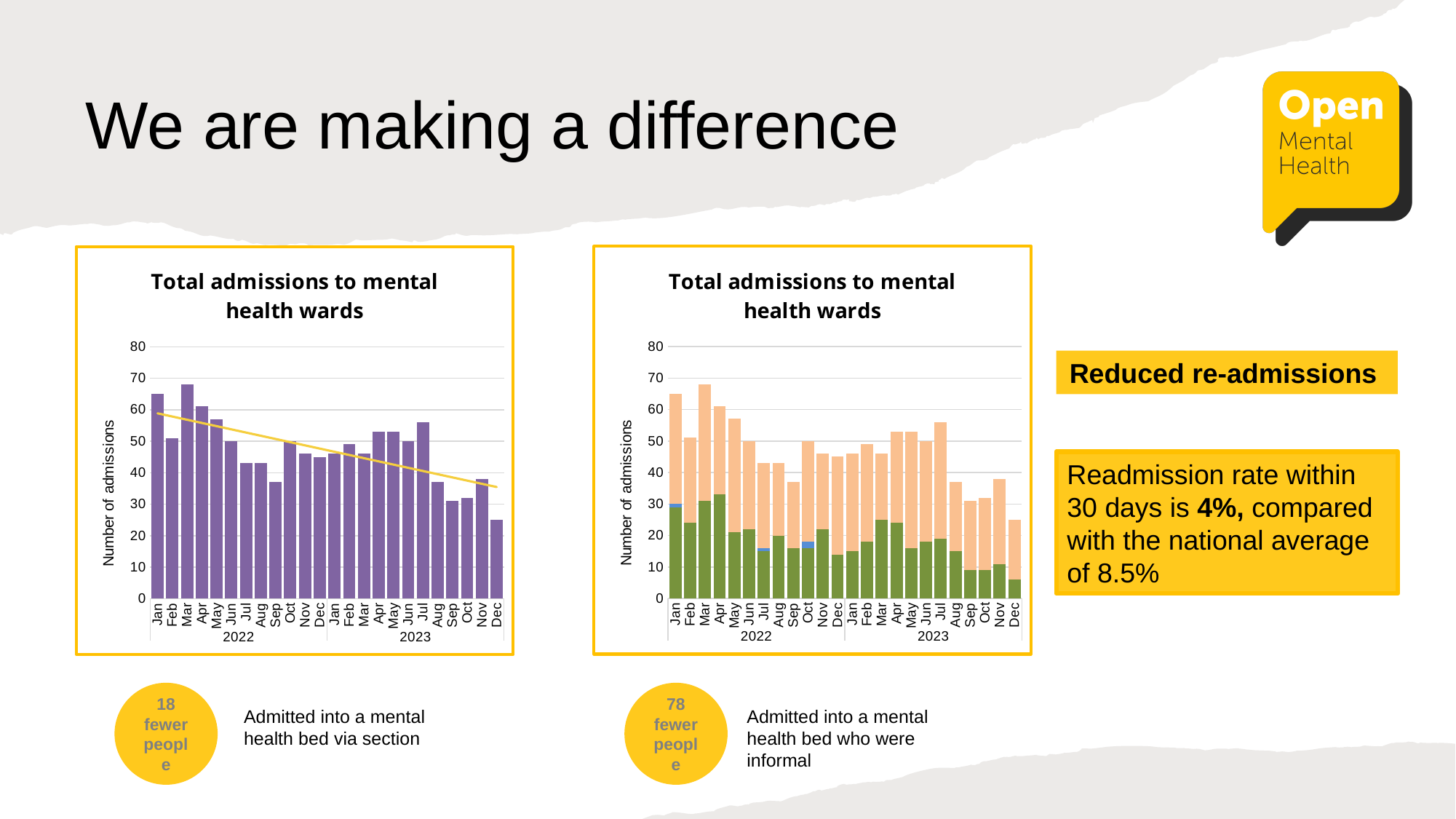
In the right chart, which month has the tallest stacked bar? Mar 2022 How many monthly bars are plotted in the left chart? 24 In the left chart, which month has the lowest number of admissions? Dec 2023 In the left chart, do admissions generally rise or fall from Jan 2022 to Dec 2023? fall What type of chart is the right chart titled 'Total admissions to mental health wards'? stacked bar chart In the left chart, is the value for Jan 2022 greater or less than 60? greater In the left chart, which is larger: the value for Jan 2022 or the value for Dec 2023? Jan 2022 In the left chart, which month has the highest number of admissions? Mar 2022 In the right chart, is the total for Dec 2023 greater or less than 30? less In the left chart, is the value for Dec 2023 greater or less than 30? less What is the y-axis label on the left chart? Number of admissions What type of chart is the left chart titled 'Total admissions to mental health wards'? bar chart